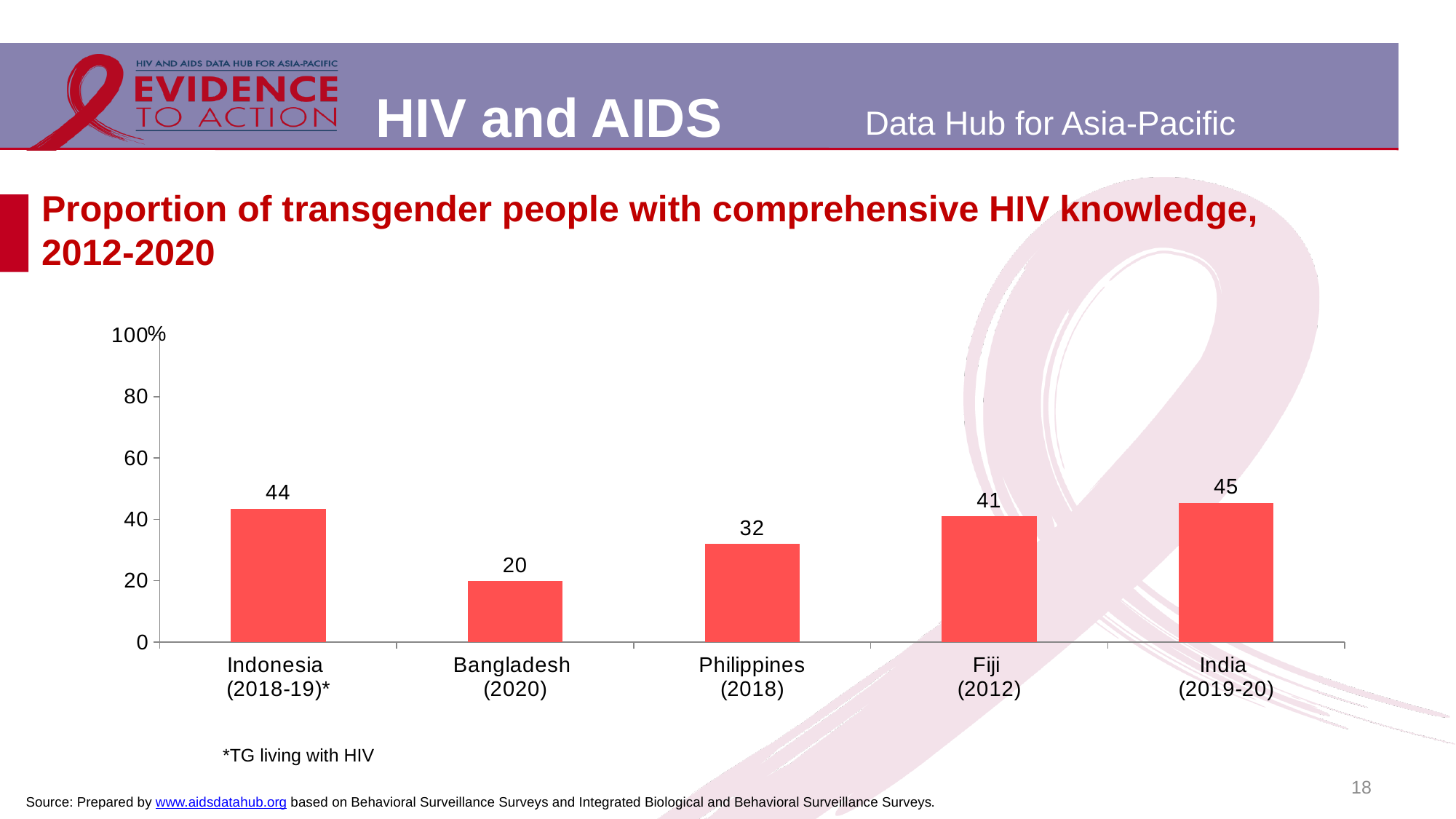
What is the difference between the values for Indonesia (2018-19) and Bangladesh (2020)? 24 What does the asterisk next to Indonesia (2018-19) indicate? TG living with HIV How many countries are shown in the chart? 5 Which country has the lowest proportion of transgender people with comprehensive HIV knowledge? Bangladesh (2020) What kind of chart is shown on the slide? bar chart Is the value for Philippines (2018) greater or less than 40? less Which country has the highest proportion of transgender people with comprehensive HIV knowledge? India (2019-20) What is the value for Philippines (2018)? 32 What is the value for Bangladesh (2020)? 20 What is the value for Fiji (2012)? 41 Which is larger, the value for Philippines (2018) or the value for Fiji (2012)? Fiji (2012) What is the value for Indonesia (2018-19)? 44